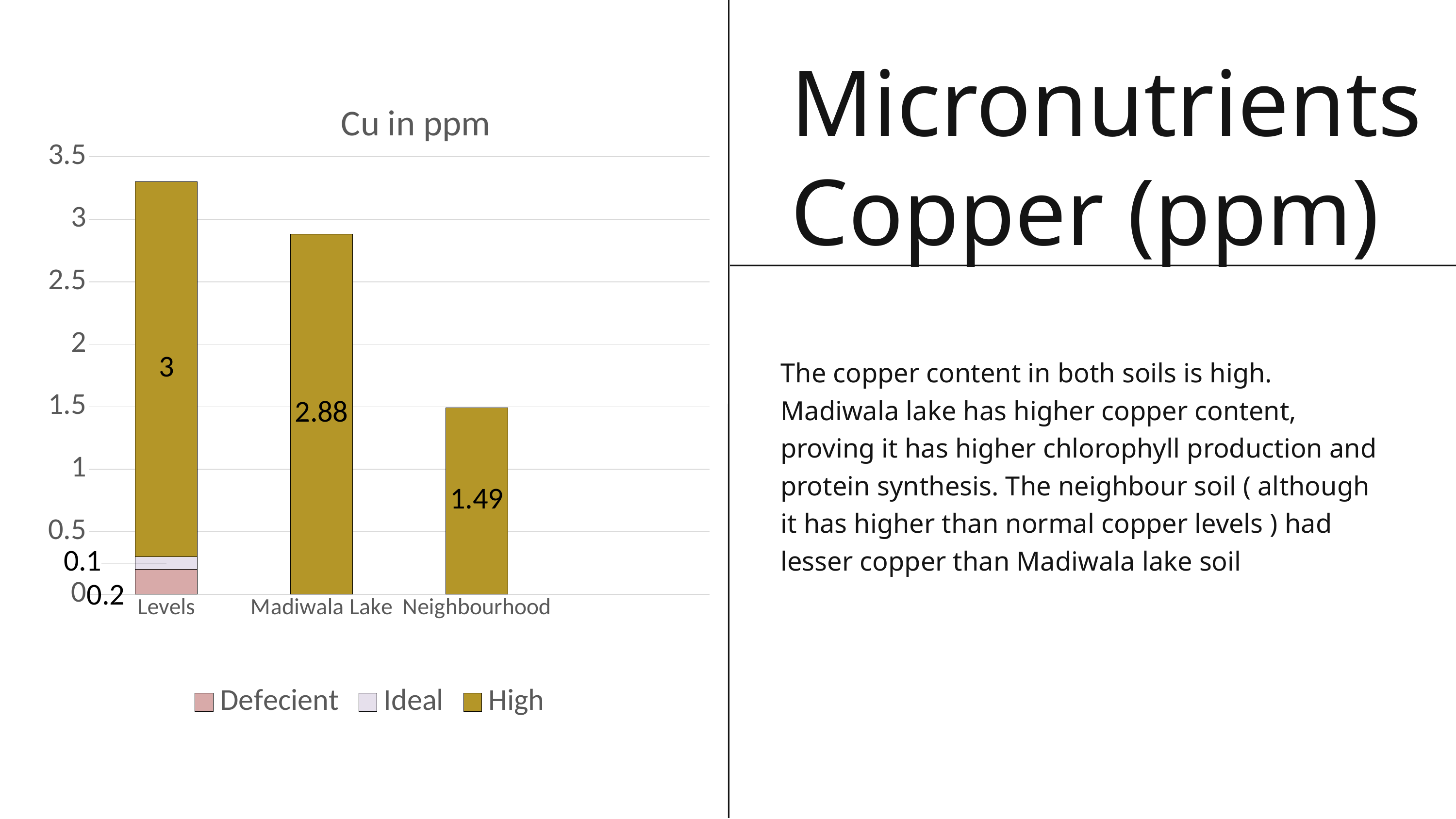
What is the High value for Madiwala Lake? 2.88 What is the Ideal value for Levels? 0.1 Which category has the highest High value? Levels How many categories are shown on the x axis? 3 How many series does the legend list? 3 What is the difference between the High values for Madiwala Lake and Neighbourhood? 1.39 What is the title of the chart? Cu in ppm Which category has the lowest High value? Neighbourhood What is the total of the stacked bar for Levels? 3.3 What is the Defecient value for Levels? 0.2 Which has a larger High value, Madiwala Lake or Neighbourhood? Madiwala Lake What is the High value for Neighbourhood? 1.49